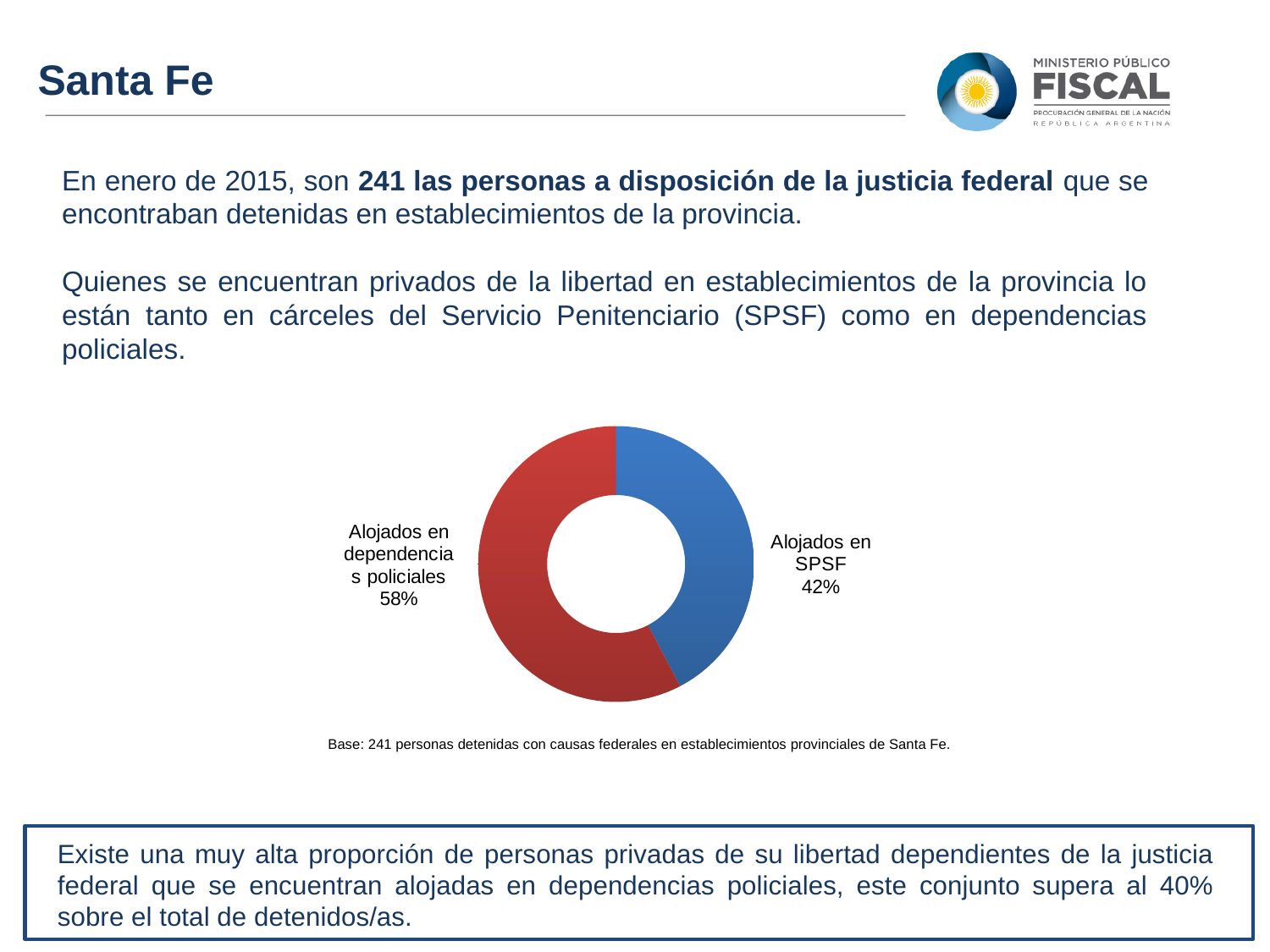
What kind of chart is shown on the slide? Pie chart (doughnut) How many slices does the pie chart have? 2 What share of the pie is labelled 'Alojados en dependencias policiales'? 58% Which is larger: the share for 'Alojados en SPSF' or the share for 'Alojados en dependencias policiales'? Alojados en dependencias policiales What is the difference in percentage points between the 'Alojados en dependencias policiales' slice and the 'Alojados en SPSF' slice? 16 percentage points Which slice of the pie is the largest? Alojados en dependencias policiales Is the share for 'Alojados en SPSF' greater or less than 50%? less Which slice of the pie is the smallest? Alojados en SPSF What share of the pie is labelled 'Alojados en SPSF'? 42% According to the base note under the chart, how many detained persons does the chart represent? 241 What colour is the 'Alojados en SPSF' slice? Blue